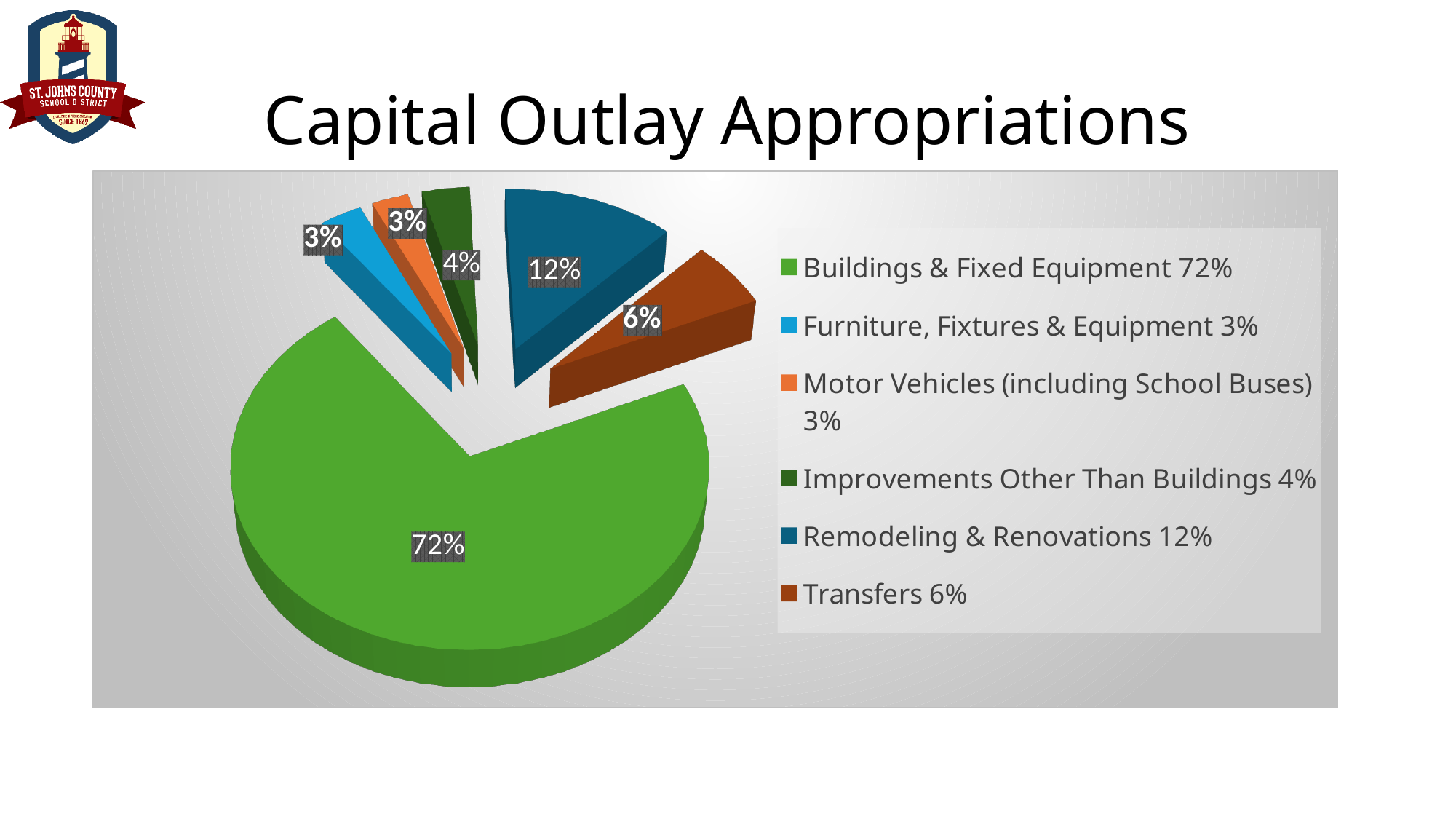
What kind of chart is shown on the slide? Pie chart How many categories does the pie chart show? 6 Which is larger, the share for Transfers or the share for Improvements Other Than Buildings? Transfers What percentage is shown for Motor Vehicles (including School Buses)? 3% What percentage is shown for Remodeling & Renovations? 12% Which category has the largest share of the pie? Buildings & Fixed Equipment What share of Capital Outlay Appropriations goes to Buildings & Fixed Equipment? 72% What is the difference in percentage points between Remodeling & Renovations and Transfers? 6 What is the title of the slide? Capital Outlay Appropriations What percentage is shown for Improvements Other Than Buildings? 4% What colour is the slice for Remodeling & Renovations? Dark blue What percentage is shown for Transfers? 6%